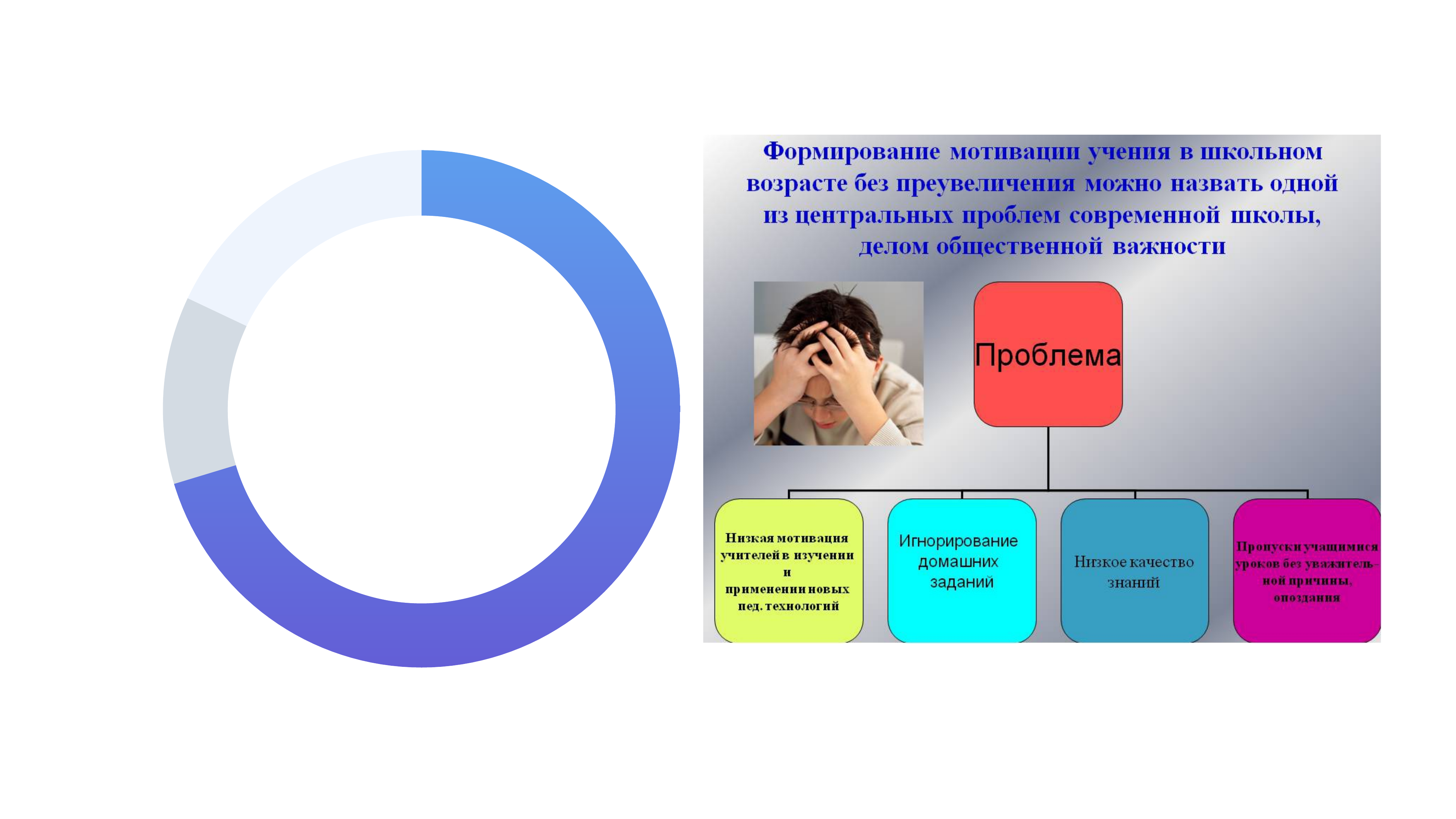
Does the doughnut chart on the left display data labels on its slices? No Which colour slice of the doughnut chart on the left is the largest? blue Does the doughnut chart on the left show a legend? No What kind of chart is shown on the left side of the slide? doughnut chart In the doughnut chart on the left, is the blue slice larger or smaller than the light grey slice? larger Which colour slice of the doughnut chart on the left is the smallest? grey How many slices does the doughnut chart on the left have? 3